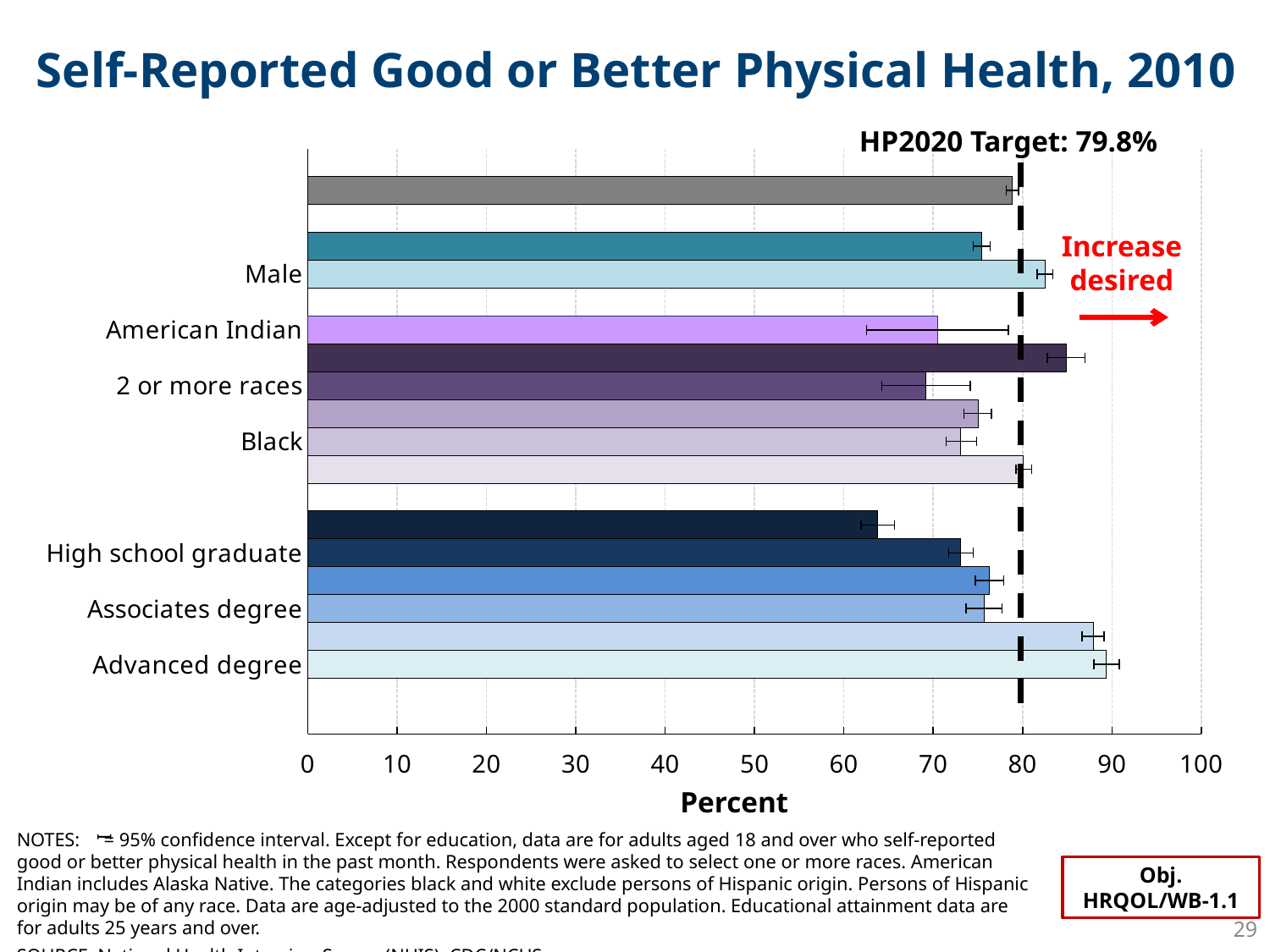
Among the labeled categories, which has the highest value? Advanced degree Is the value for Black greater or less than 80? less Which is larger, the value for Advanced degree or the value for High school graduate? Advanced degree What kind of chart is shown on the slide? bar chart Which is larger, the value for Male or the value for American Indian? Male Is the value for Male greater or less than 80? greater Is the value for 2 or more races greater or less than 75? less What is the title of the x axis? Percent What is the HP2020 Target value shown on the chart? 79.8%